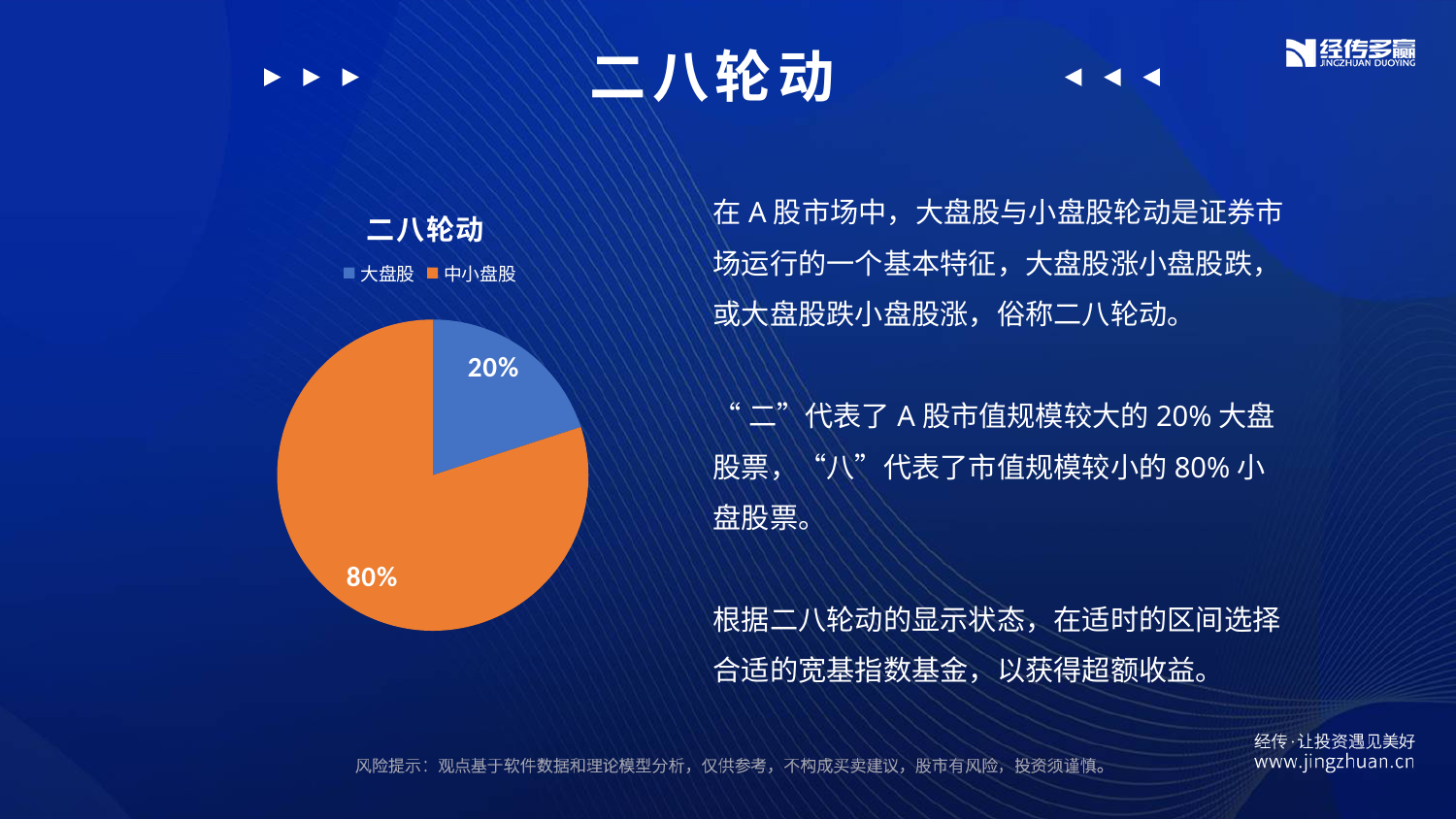
What type of chart is shown on the slide? pie chart Which category has the largest slice of the pie? 中小盘股 What is the chart's title? 二八轮动 Which is larger, the share of 大盘股 or the share of 中小盘股? 中小盘股 What share of the pie does 大盘股 represent? 20% What is the total of the two slices shown? 100% What share of the pie does 中小盘股 represent? 80% What is the difference between the shares of 中小盘股 and 大盘股? 60% Which category has the smallest slice of the pie? 大盘股 How many categories does the pie chart have? 2 What colour is the 中小盘股 slice? orange How many entries does the legend list? 2